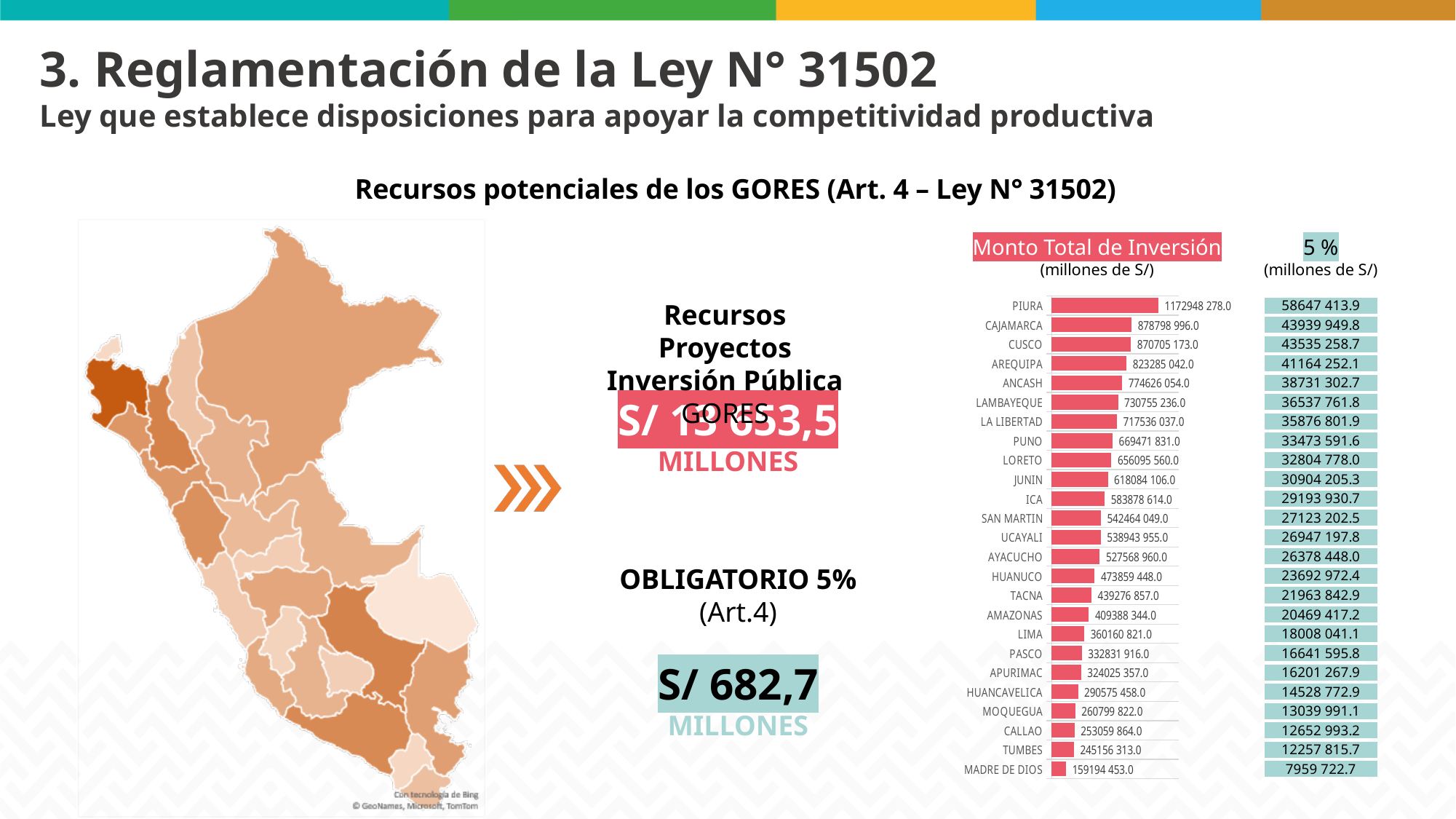
How many regions are listed in the Monto Total de Inversión bar chart? 25 What kind of chart shows the Monto Total de Inversión by region? bar chart In the Monto Total de Inversión bar chart, what is the value for PIURA? 1172948 278.0 What is the title of the bar chart on the right of the slide? Monto Total de Inversión In the Monto Total de Inversión bar chart, what is the value for MADRE DE DIOS? 159194 453.0 In the Monto Total de Inversión bar chart, which is larger, the value for TACNA or the value for AMAZONAS? TACNA In the Monto Total de Inversión bar chart, what is the value for LORETO? 656095 560.0 Do the values in the Monto Total de Inversión bar chart rise or fall going from PIURA at the top to MADRE DE DIOS at the bottom? fall Which region has the lowest Monto Total de Inversión? MADRE DE DIOS In the Monto Total de Inversión bar chart, which is larger, the value for CAJAMARCA or the value for CUSCO? CAJAMARCA In the Monto Total de Inversión bar chart, what is the value for LIMA? 360160 821.0 Which region has the highest Monto Total de Inversión? PIURA